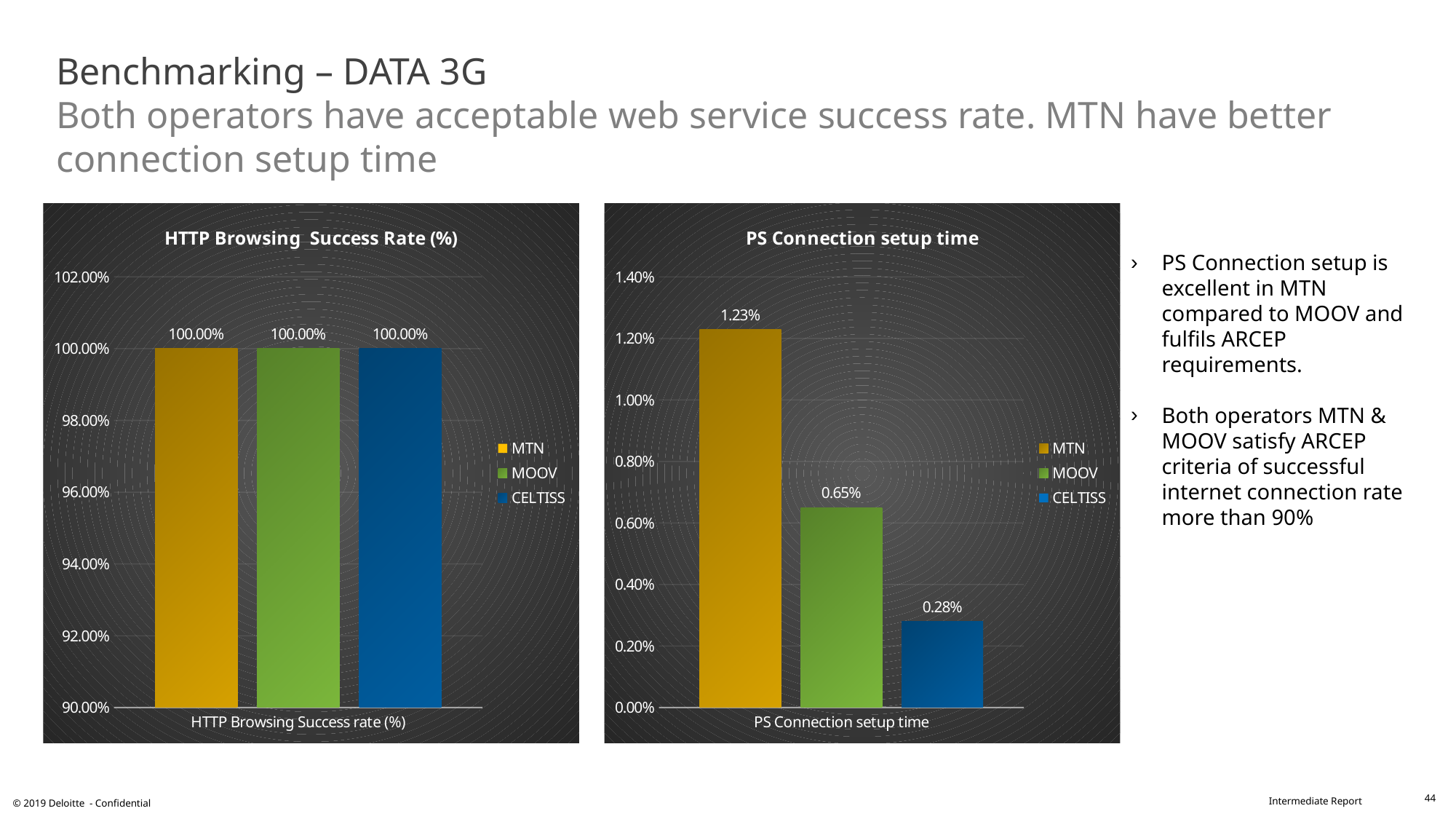
How many series does the legend of the 'HTTP Browsing Success Rate (%)' chart list? 3 In the 'PS Connection setup time' chart, which operator has the highest value? MTN In the 'PS Connection setup time' chart, what is the value for CELTISS? 0.28% What kind of chart is the 'PS Connection setup time' chart? bar chart In the 'PS Connection setup time' chart, which operator has the lowest value? CELTISS In the 'PS Connection setup time' chart, what is the value for MTN? 1.23% In the 'PS Connection setup time' chart, what is the difference between the MTN and MOOV values? 0.58% In the 'PS Connection setup time' chart, is the value for MOOV larger or smaller than the value for CELTISS? larger In the 'HTTP Browsing Success Rate (%)' chart, what is the value for CELTISS? 100.00% In the 'PS Connection setup time' chart, which colour represents MOOV? green In the 'PS Connection setup time' chart, what is the value for MOOV? 0.65% In the 'HTTP Browsing Success Rate (%)' chart, what is the value for MTN? 100.00%